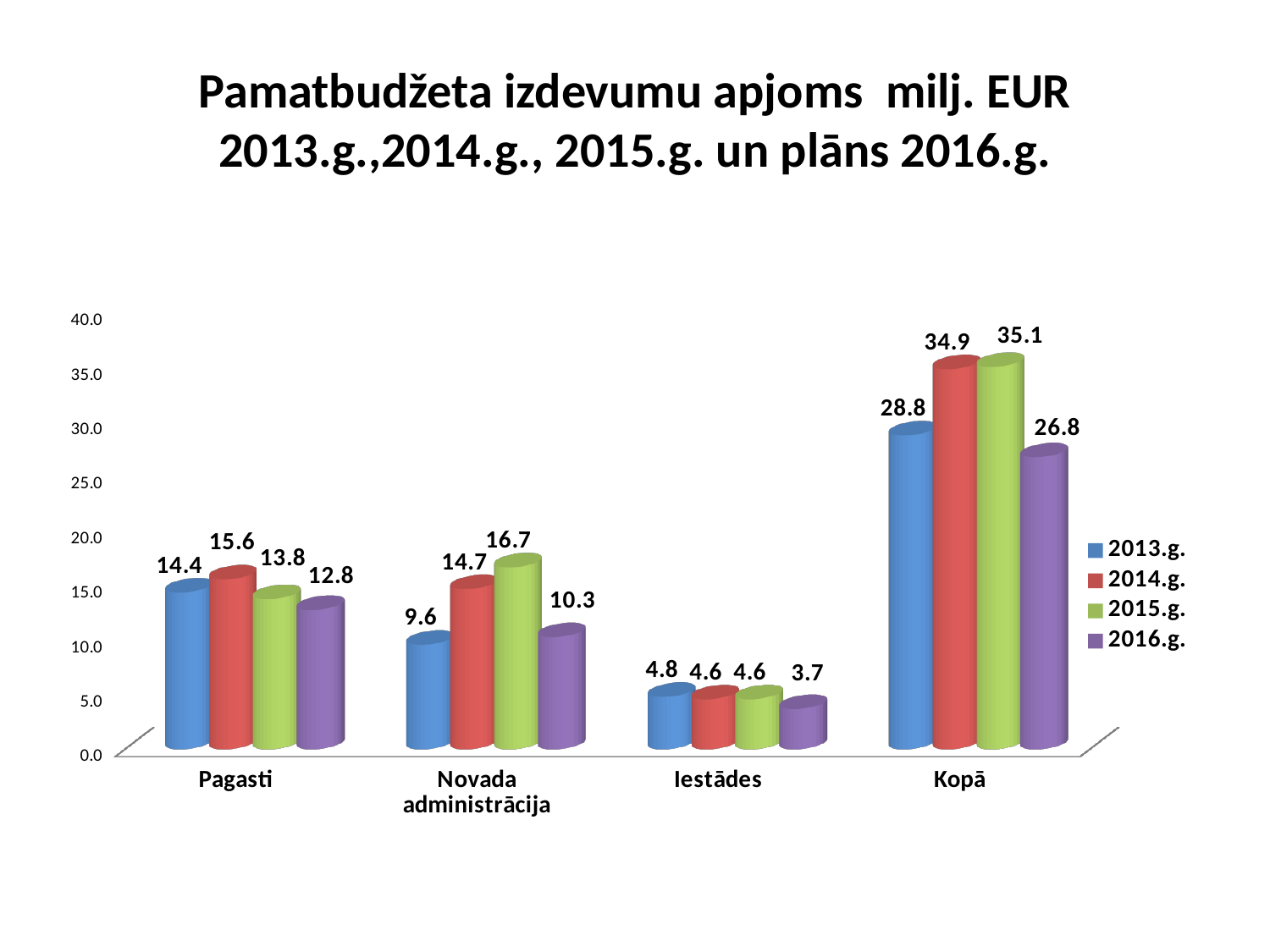
Which series is shown in green in the legend? 2015.g. Which category has the highest value in the 2014.g. series? Kopā How many series does the legend list? 4 What is the value for Iestādes in the 2016.g. series? 3.7 What is the value for Kopā in the 2013.g. series? 28.8 What is the difference between the 2015.g. and 2016.g. values for Kopā? 8.3 Which is larger for Pagasti: the 2014.g. value or the 2016.g. value? 2014.g. What is the value for Novada administrācija in the 2015.g. series? 16.7 What kind of chart is shown on the slide? Bar chart How many categories are shown on the x axis? 4 Which category has the lowest value in the 2013.g. series? Iestādes What is the difference between the 2013.g. and 2015.g. values for Novada administrācija? 7.1